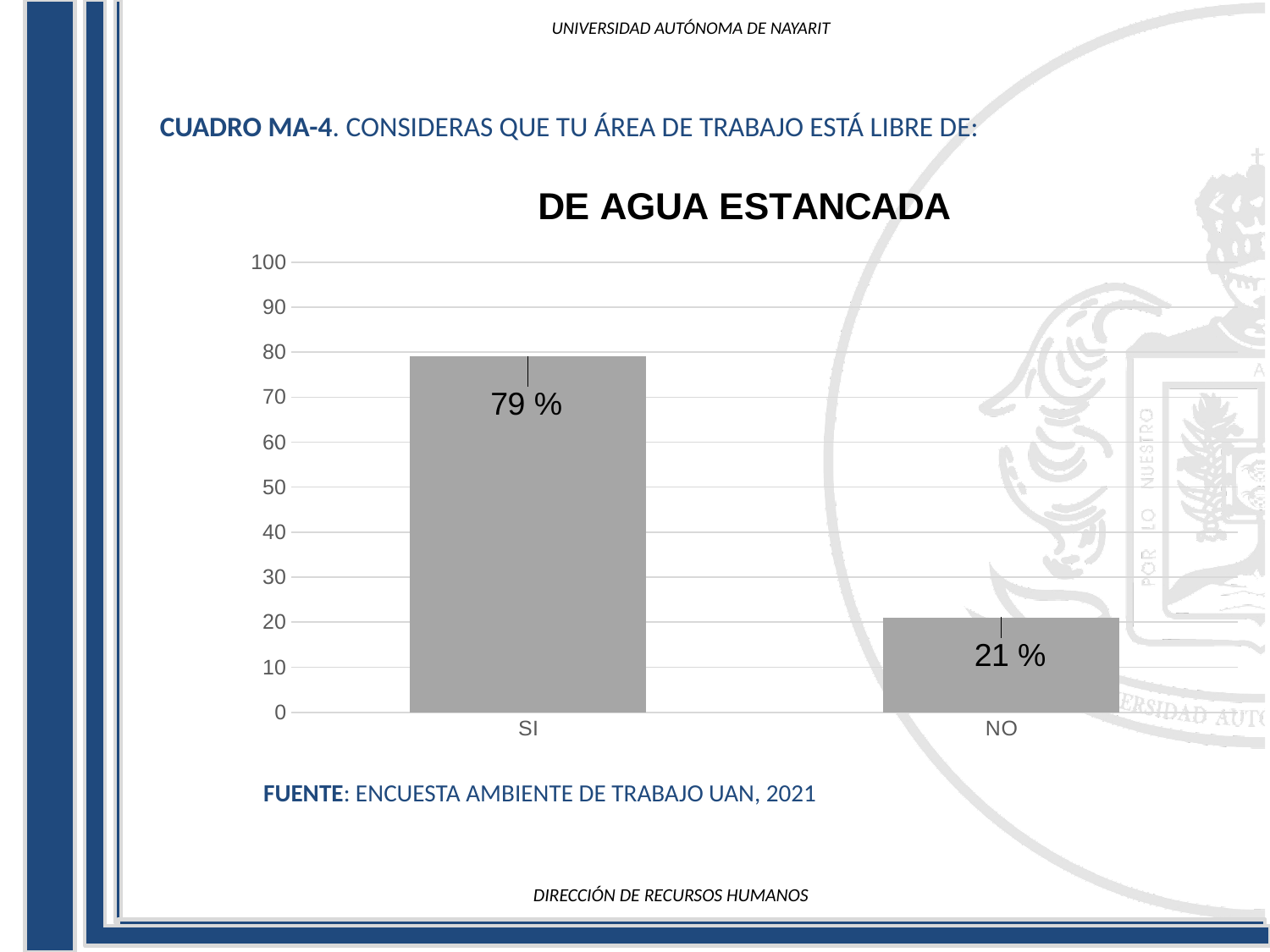
What kind of chart is shown? bar chart Which is larger, the value for SI or the value for NO? SI Is the value for NO greater or less than 30? less How many categories are shown on the x axis? 2 What is the maximum value shown on the y axis? 100 Which category has the lowest value? NO Which category has the highest value? SI What is the value for NO? 21 % Is the value for SI greater or less than 70? greater What is the difference between the values for SI and NO? 58 % What is the value for SI? 79 % What is the title of the chart? DE AGUA ESTANCADA